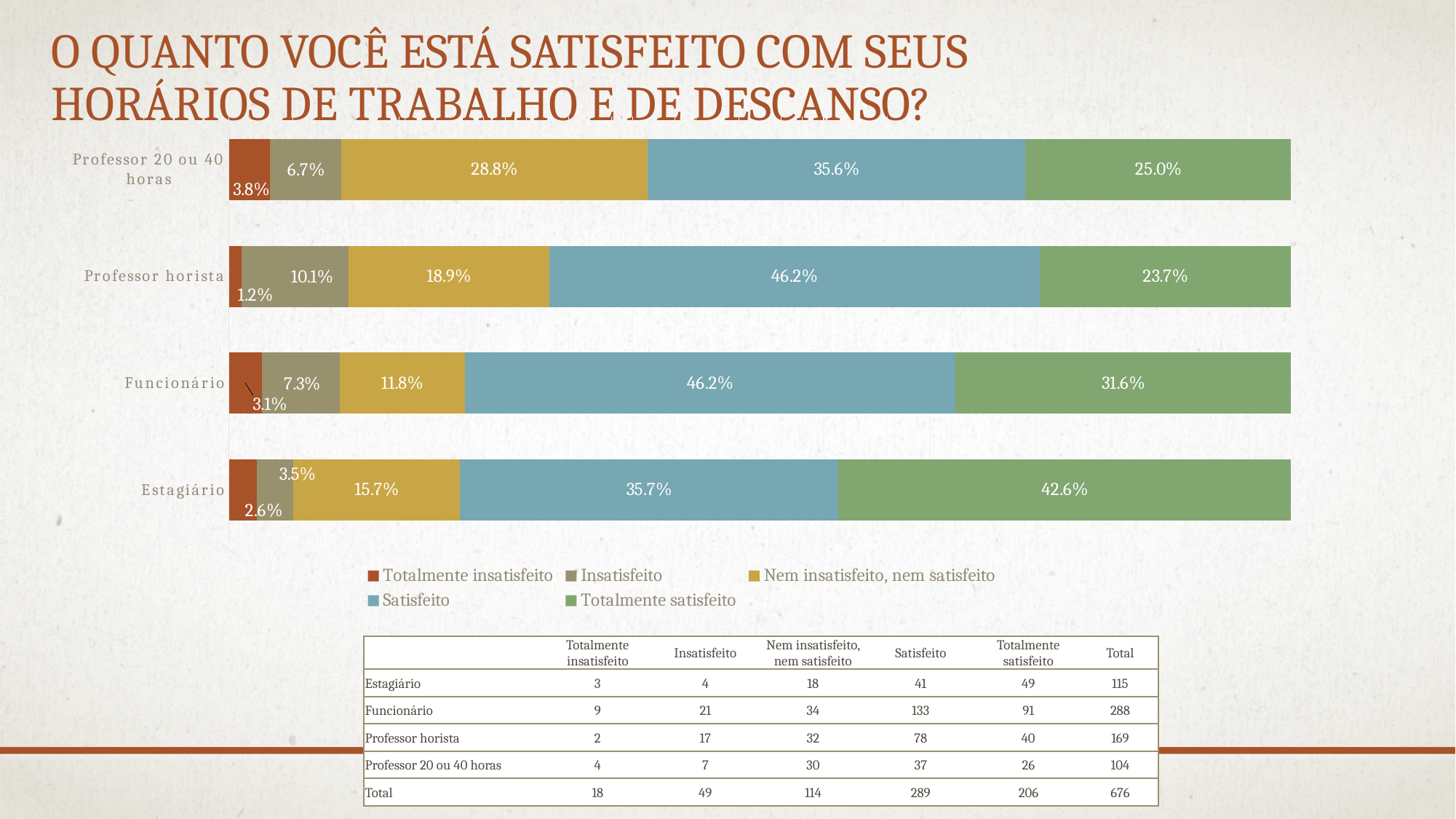
What is the difference in percentage points between the Totalmente satisfeito values for Funcionário and Professor 20 ou 40 horas? 6.6 percentage points What percentage of Professor horista respondents answered Satisfeito? 46.2% Which category has the highest Nem insatisfeito, nem satisfeito share? Professor 20 ou 40 horas Which category has the lowest Totalmente insatisfeito share? Professor horista What is the Insatisfeito value for Estagiário? 3.5% Which category has the highest Totalmente satisfeito share? Estagiário What is the Totalmente satisfeito value for Estagiário? 42.6% How many series does the legend list? 5 What type of chart is shown on the slide? Stacked horizontal bar chart Which has a larger Insatisfeito share, Professor horista or Funcionário? Professor horista How many categories (bars) are shown in the chart? 4 What is the Nem insatisfeito, nem satisfeito value for Professor 20 ou 40 horas? 28.8%